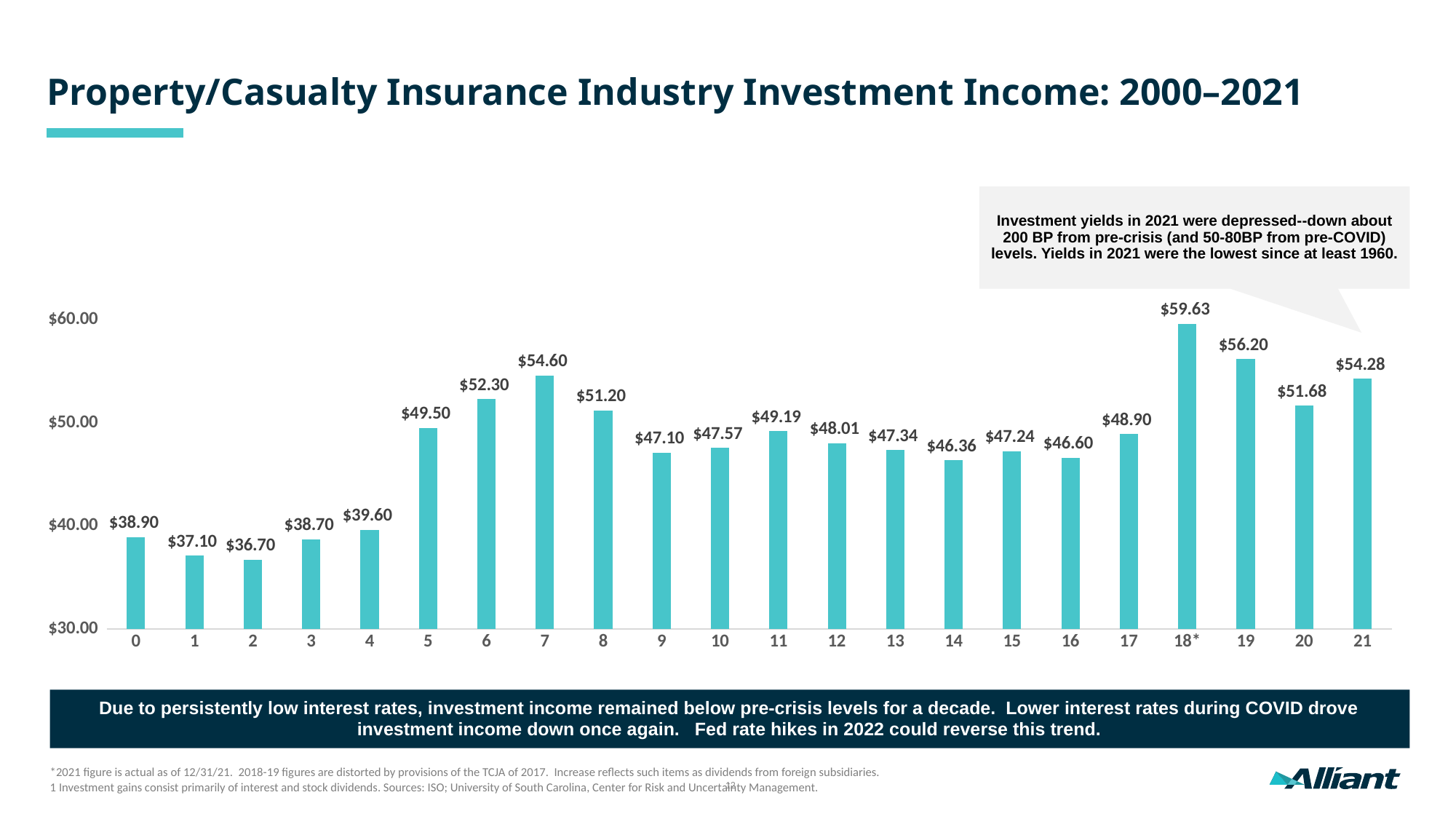
What is the title of the chart? Property/Casualty Insurance Industry Investment Income: 2000–2021 Which category has the highest investment income? 18* What is the difference between the values for category 19 and category 20? $4.52 Which category has the lowest investment income? 2 What is the investment income value for category 18*? $59.63 What is the investment income value for category 2? $36.70 How many categories are shown on the x axis? 22 Which is larger, the value for category 7 or the value for category 8? 7 Is the value for category 4 greater or less than $40.00? less Do the values rise or fall from category 0 to category 2? fall What is the investment income value for category 21? $54.28 What kind of chart is shown on the slide? bar chart